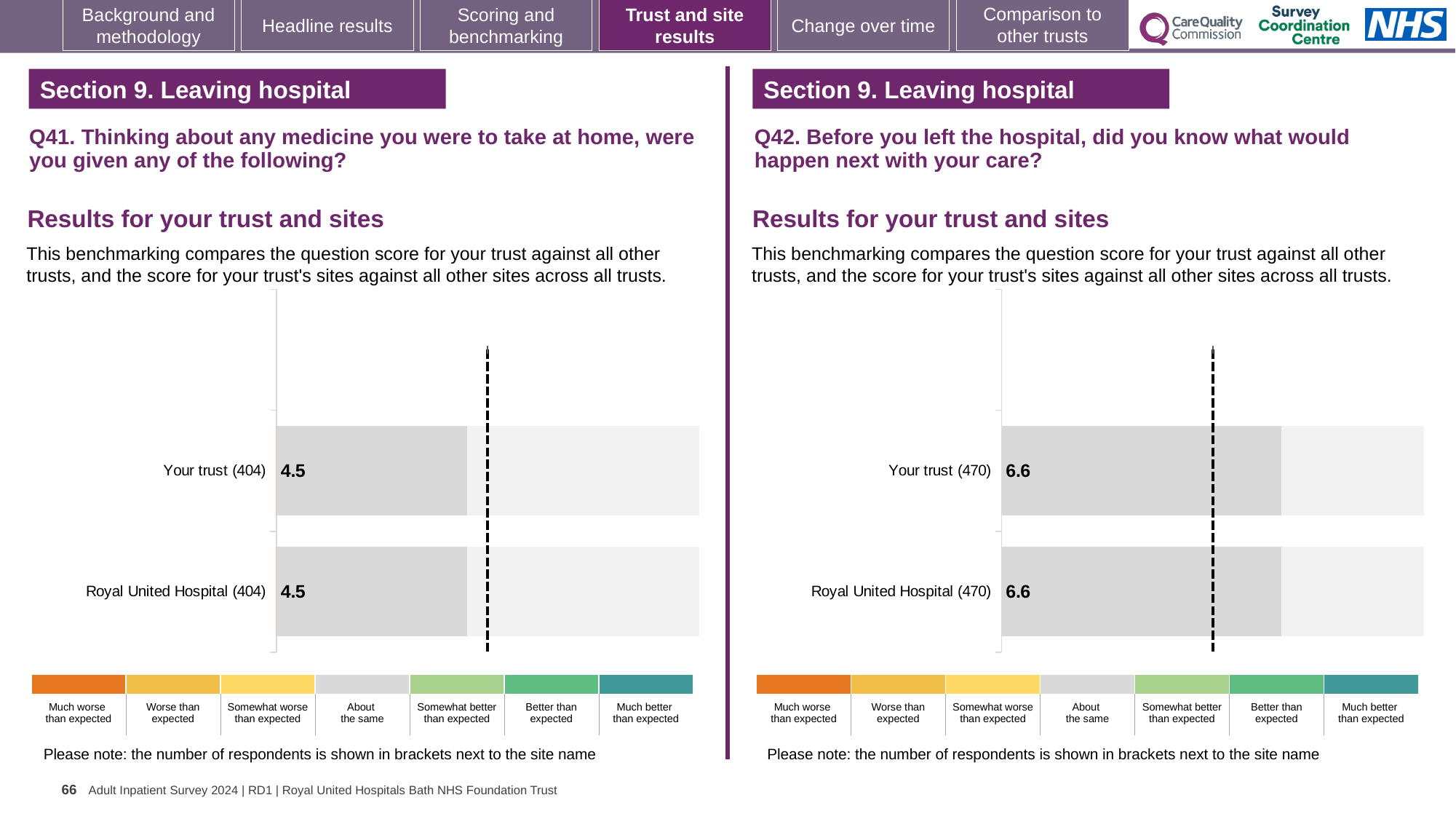
On the Q41 chart (left), what is the score for Royal United Hospital? 4.5 On the Q41 chart (left), what is the difference between the score for Your trust and the score for Royal United Hospital? 0 Is the score for Your trust on the Q42 chart (right) larger or smaller than the score for Your trust on the Q41 chart (left)? Larger On the Q42 chart (right), how many respondents are shown in brackets next to Royal United Hospital? 470 How many bars are plotted on the Q41 chart (left)? 2 On the Q42 chart (right), what is the score for Your trust? 6.6 On the Q41 chart (left), how many respondents are shown in brackets next to Your trust? 404 On the Q41 chart (left), what is the score for Your trust? 4.5 What kind of chart is the Q42 chart (right)? Bar chart How many bars are plotted on the Q42 chart (right)? 2 On the Q42 chart (right), what is the difference between the score for Your trust and the score for Royal United Hospital? 0 On the Q42 chart (right), what is the score for Royal United Hospital? 6.6